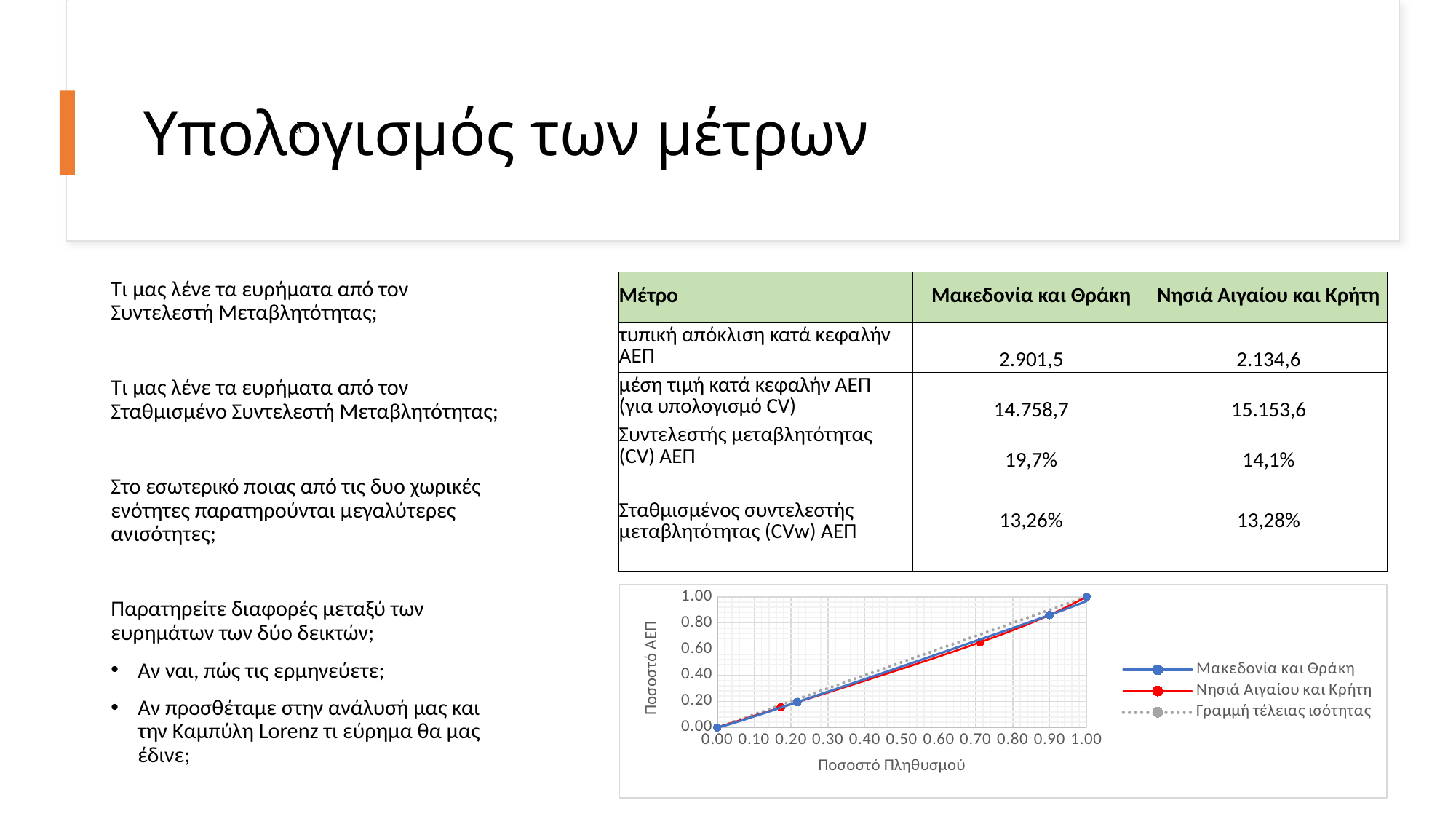
In the line chart, what is the highest Ποσοστό ΑΕΠ value reached by the Μακεδονία και Θράκη series? 1.00 In the line chart, do the values of the Μακεδονία και Θράκη series rise or fall as Ποσοστό Πληθυσμού increases? rise In the line chart, is the Ποσοστό ΑΕΠ value of the Νησιά Αιγαίου και Κρήτη series at its third marker (around Ποσοστό Πληθυσμού 0.70) greater or less than 0.80? less What is the title of the y axis of the line chart? Ποσοστό ΑΕΠ In the line chart, is the Ποσοστό ΑΕΠ value of the Νησιά Αιγαίου και Κρήτη series at its third marker (around Ποσοστό Πληθυσμού 0.70) greater or less than 0.60? greater How many series does the legend of the line chart list? 3 In the line chart, what is the Ποσοστό ΑΕΠ value of the Νησιά Αιγαίου και Κρήτη series at Ποσοστό Πληθυσμού 1.00? 1.00 In the line chart, what is the Ποσοστό ΑΕΠ value of the Μακεδονία και Θράκη series at Ποσοστό Πληθυσμού 0.00? 0.00 What is the title of the x axis of the line chart? Ποσοστό Πληθυσμού In the line chart, how many markers does the Μακεδονία και Θράκη series have? 4 What kind of chart is shown at the bottom right of the slide? line chart In the line chart, is the Ποσοστό ΑΕΠ value of the Μακεδονία και Θράκη series at its second marker (around Ποσοστό Πληθυσμού 0.20) greater or less than 0.40? less